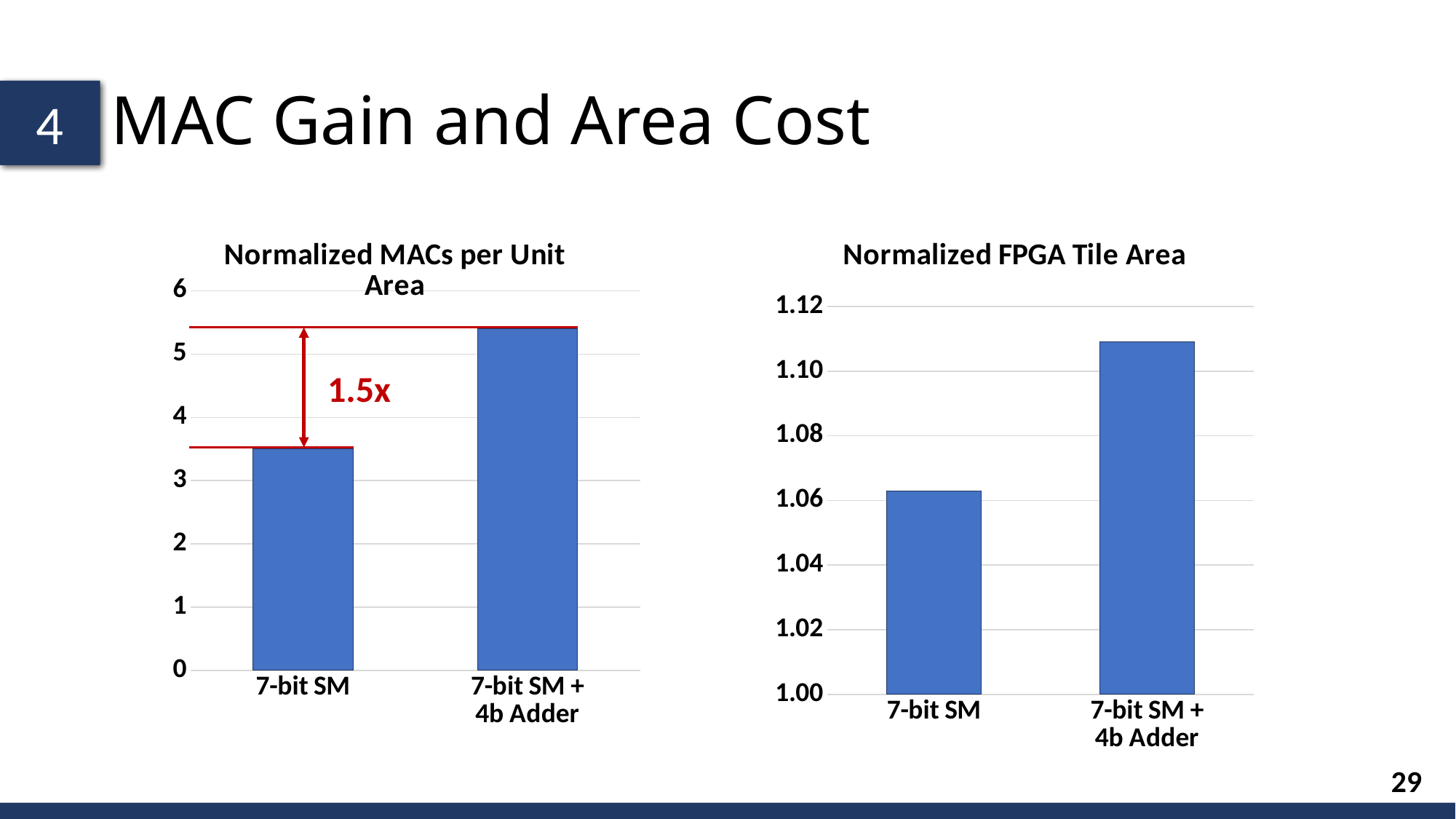
In the 'Normalized FPGA Tile Area' chart, is the value for 7-bit SM + 4b Adder greater or less than 1.12? less In the 'Normalized MACs per Unit Area' chart, is the value for 7-bit SM greater or less than 3? greater In the 'Normalized FPGA Tile Area' chart, is the value for 7-bit SM greater or less than 1.08? less In the 'Normalized MACs per Unit Area' chart, which category has the highest value? 7-bit SM + 4b Adder What type of chart is the 'Normalized MACs per Unit Area' chart? bar chart In the 'Normalized MACs per Unit Area' chart, what gain factor is annotated between the two bars? 1.5x In the 'Normalized MACs per Unit Area' chart, which category has the lowest value? 7-bit SM In the 'Normalized FPGA Tile Area' chart, which category has the highest value? 7-bit SM + 4b Adder How many categories are shown in the 'Normalized FPGA Tile Area' chart? 2